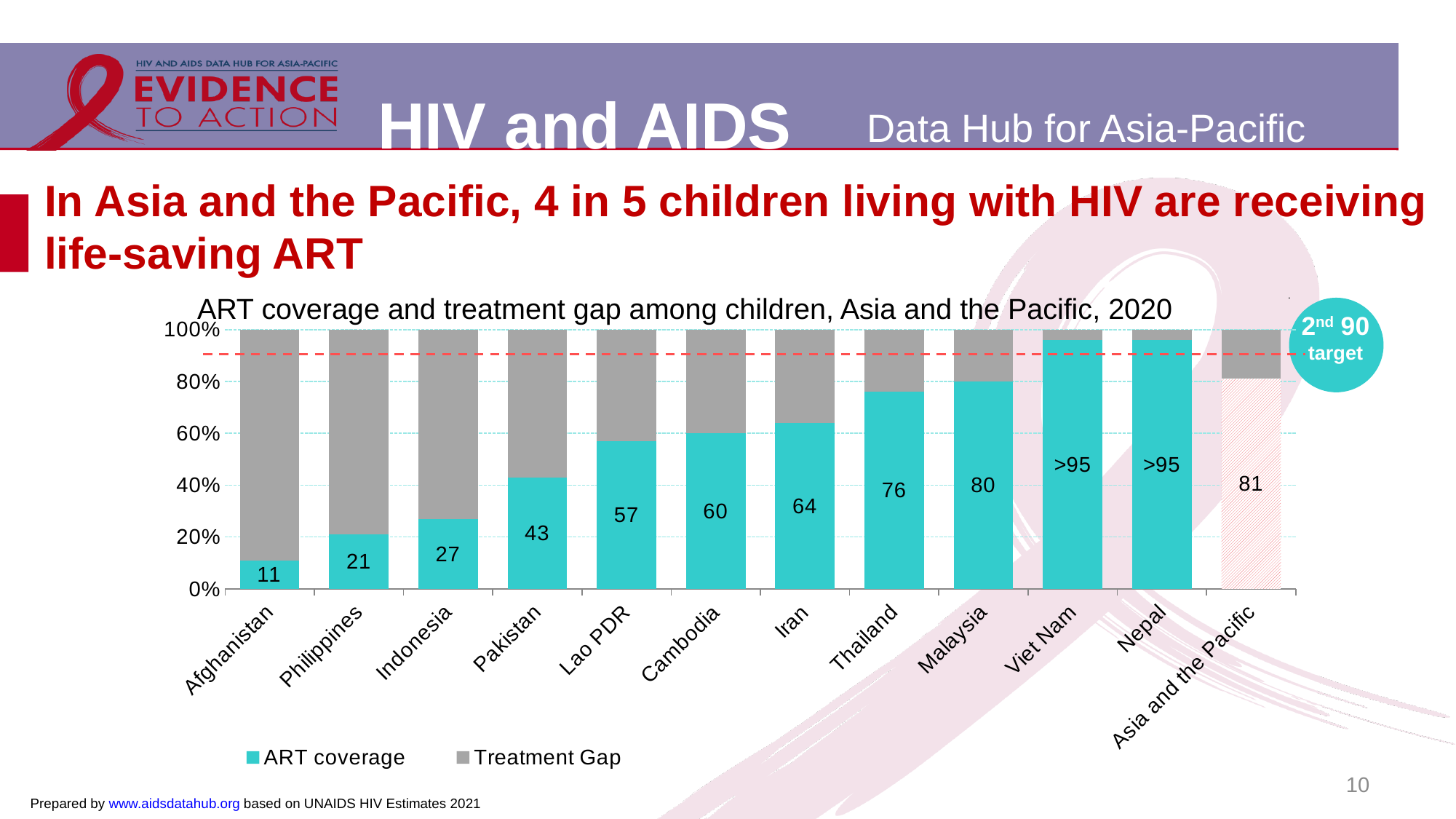
Which has a higher ART coverage value, Cambodia or Lao PDR? Cambodia What kind of chart is shown on the slide? Stacked bar chart What is the ART coverage value shown for Asia and the Pacific? 81 What is the ART coverage value shown for Viet Nam? >95 Which country has the lowest ART coverage in the chart? Afghanistan What is the ART coverage value shown for Thailand? 76 How many series does the chart legend list? 2 What is the difference between the ART coverage values for Malaysia and Thailand? 4 How many categories are shown on the x axis of the chart? 12 Which series in the legend is shown in grey? Treatment Gap Is the ART coverage for Indonesia greater or less than 40%? less What is the ART coverage value shown for Afghanistan? 11